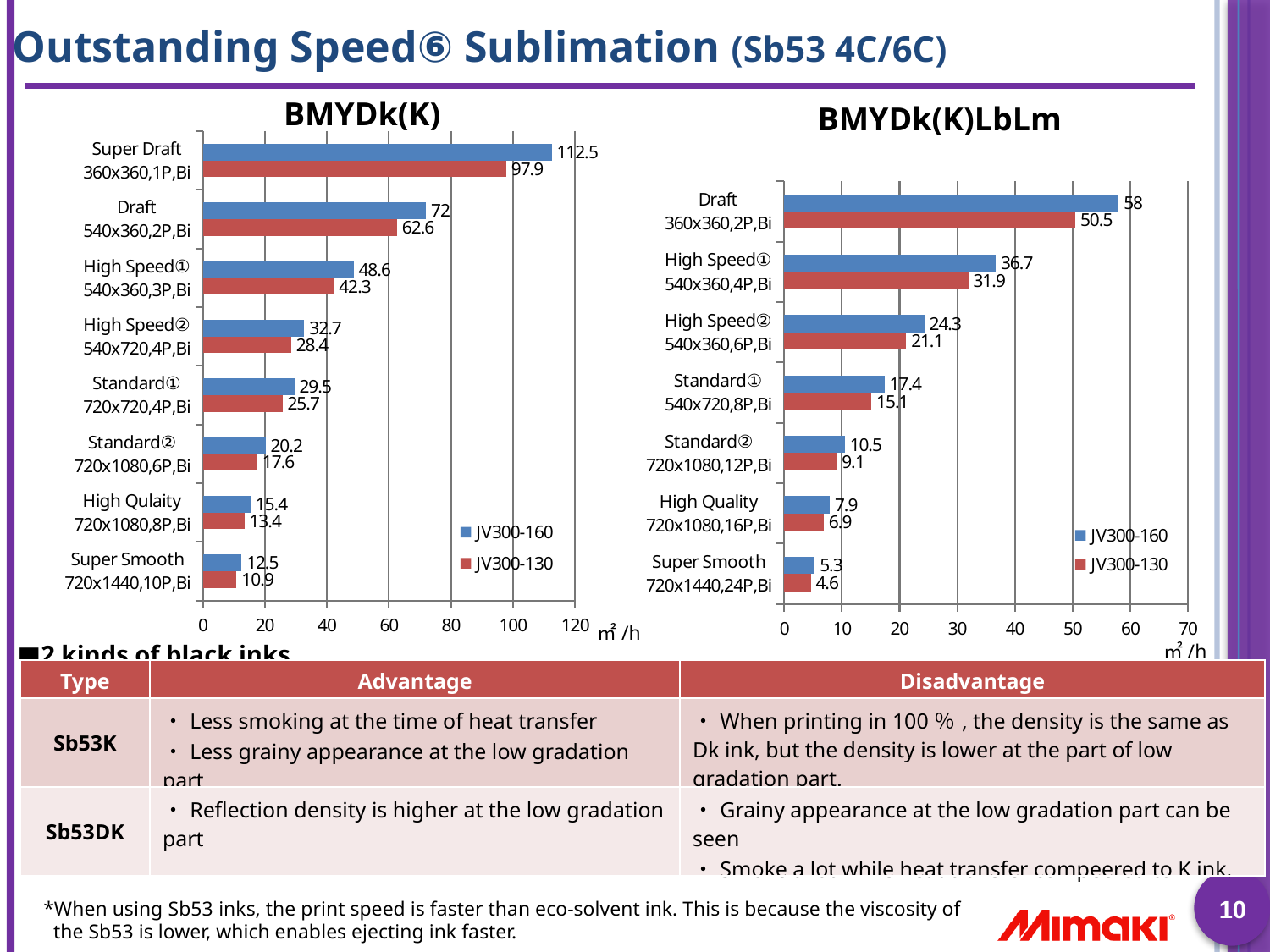
In the BMYDk(K) chart, which is larger for High Speed①: the JV300-160 value or the JV300-130 value? JV300-160 In the BMYDk(K) chart, which print mode has the lowest JV300-130 value? Super Smooth How many print modes are shown in the BMYDk(K)LbLm chart? 7 In the BMYDk(K) chart, what is the difference between the JV300-160 and JV300-130 values for Super Draft? 14.6 In the BMYDk(K)LbLm chart, what is the JV300-160 value for High Speed①? 36.7 In the BMYDk(K) chart, what is the JV300-130 value for Draft? 62.6 In the BMYDk(K)LbLm chart, what is the JV300-130 value for Super Smooth? 4.6 What type of chart is the BMYDk(K) chart? Bar chart In the BMYDk(K)LbLm chart, which print mode has the highest JV300-160 value? Draft In the BMYDk(K)LbLm chart, what is the difference between the JV300-160 and JV300-130 values for Draft? 7.5 How many series does the legend of the BMYDk(K) chart list? 2 In the BMYDk(K) chart, what is the JV300-160 value for Super Draft? 112.5